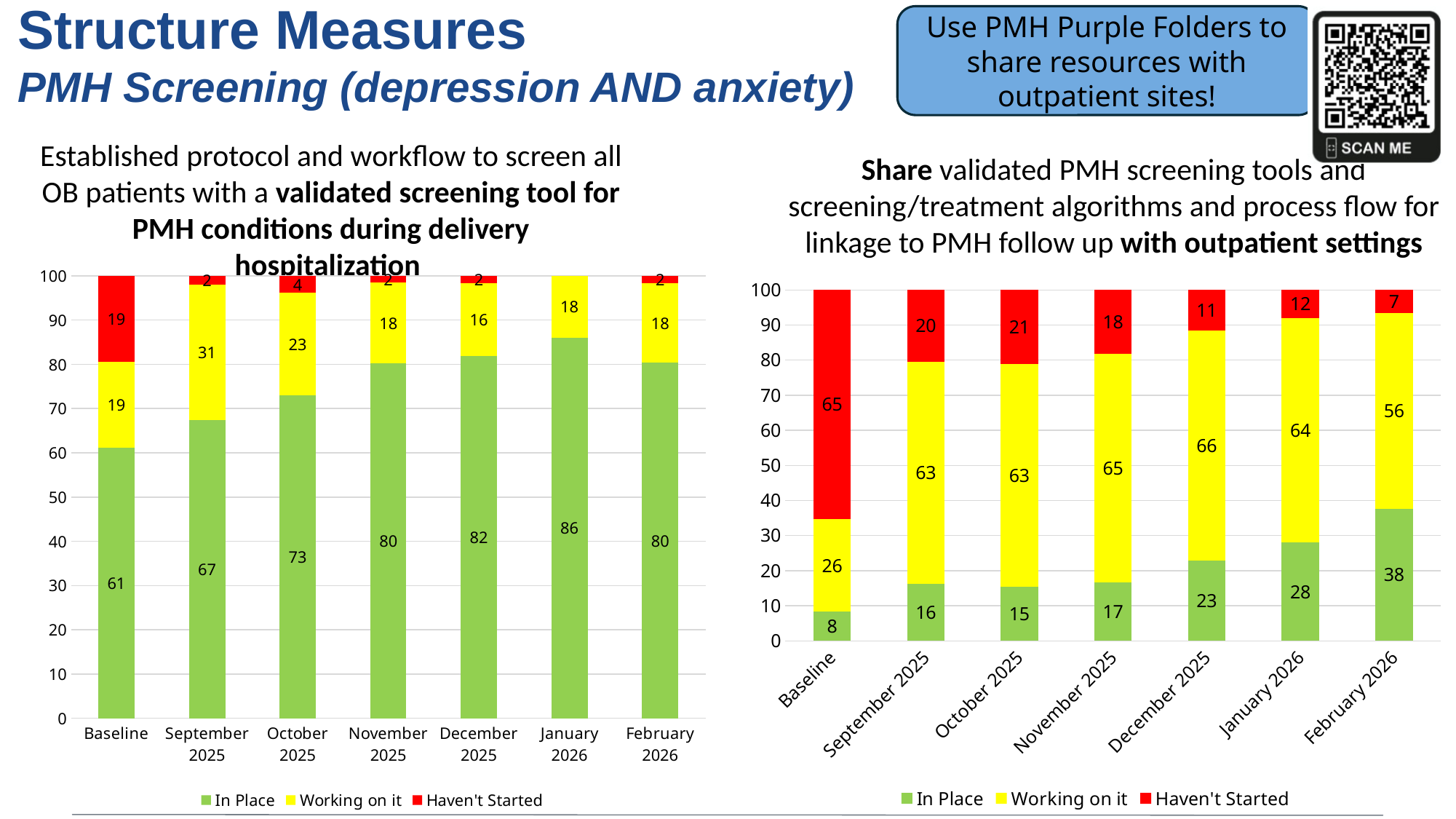
On the left chart, what is the Working on it value for September 2025? 31 On the left chart, what is the difference between the In Place values for February 2026 and Baseline? 19 On the left chart, what is the In Place value for Baseline? 61 On the left chart, how many categories are shown on the x axis? 7 On the right chart, is the In Place value for December 2025 larger than the In Place value for October 2025? Yes On the right chart, what is the In Place value for February 2026? 38 On the left chart, which category has the highest In Place value? January 2026 On the right chart, which category has the lowest In Place value? Baseline On the right chart, what is the Haven't Started value for Baseline? 65 What kind of chart is the left chart? stacked bar chart On the right chart, does the In Place value rise or fall from Baseline to February 2026? rise How many series does the legend of the right chart list? 3